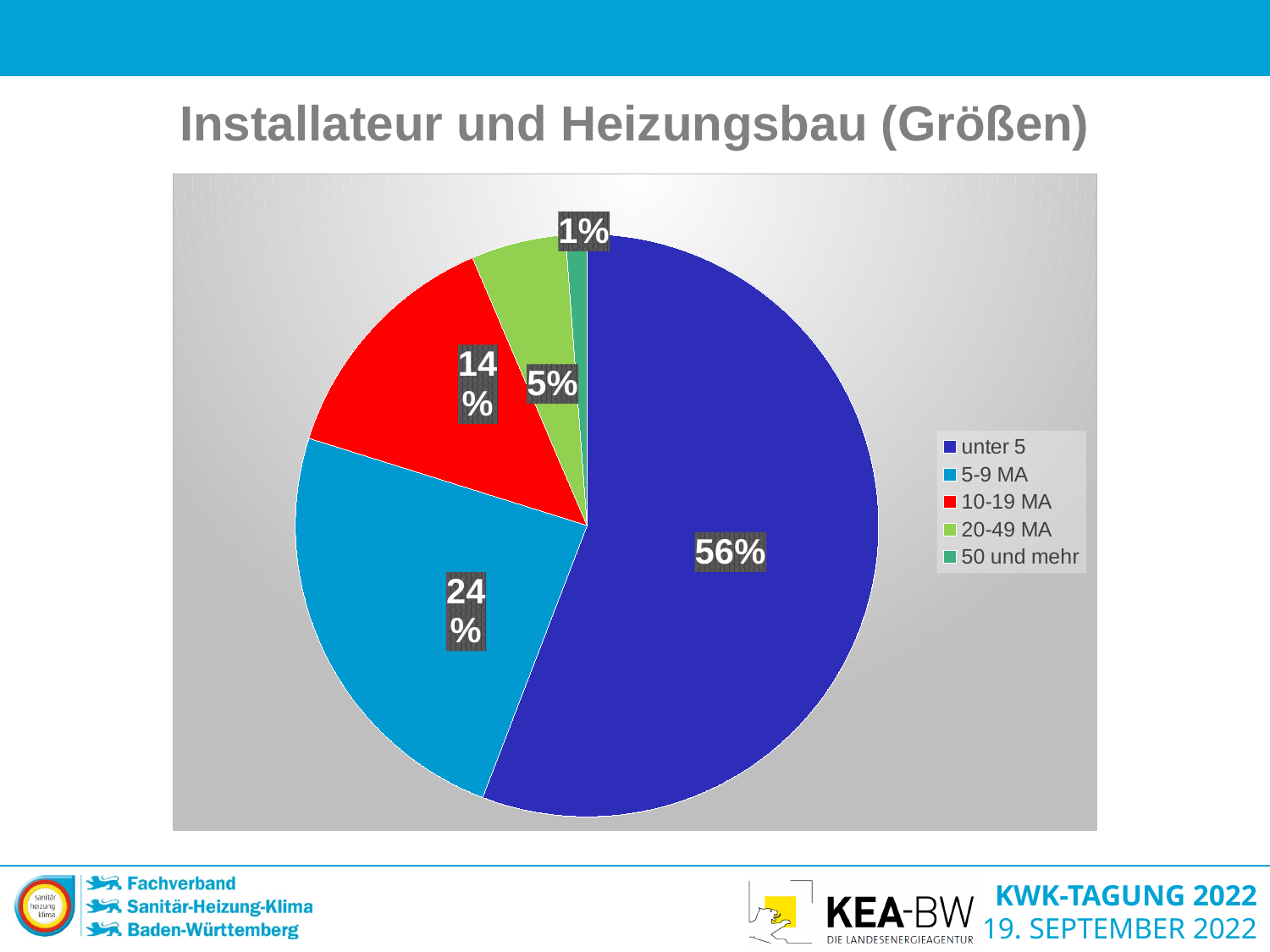
What share of the pie does the '50 und mehr' category have? 1% What share of the pie does the '5-9 MA' category have? 24% What is the title of the slide? Installateur und Heizungsbau (Größen) Which category has the smallest slice of the pie? 50 und mehr What kind of chart is shown on the slide? pie chart Which slice is larger, '10-19 MA' or '20-49 MA'? 10-19 MA Which category has the largest slice of the pie? unter 5 What share of the pie does the '20-49 MA' category have? 5% How many categories does the legend list? 5 What is the difference in percentage points between the 'unter 5' and '5-9 MA' slices? 32